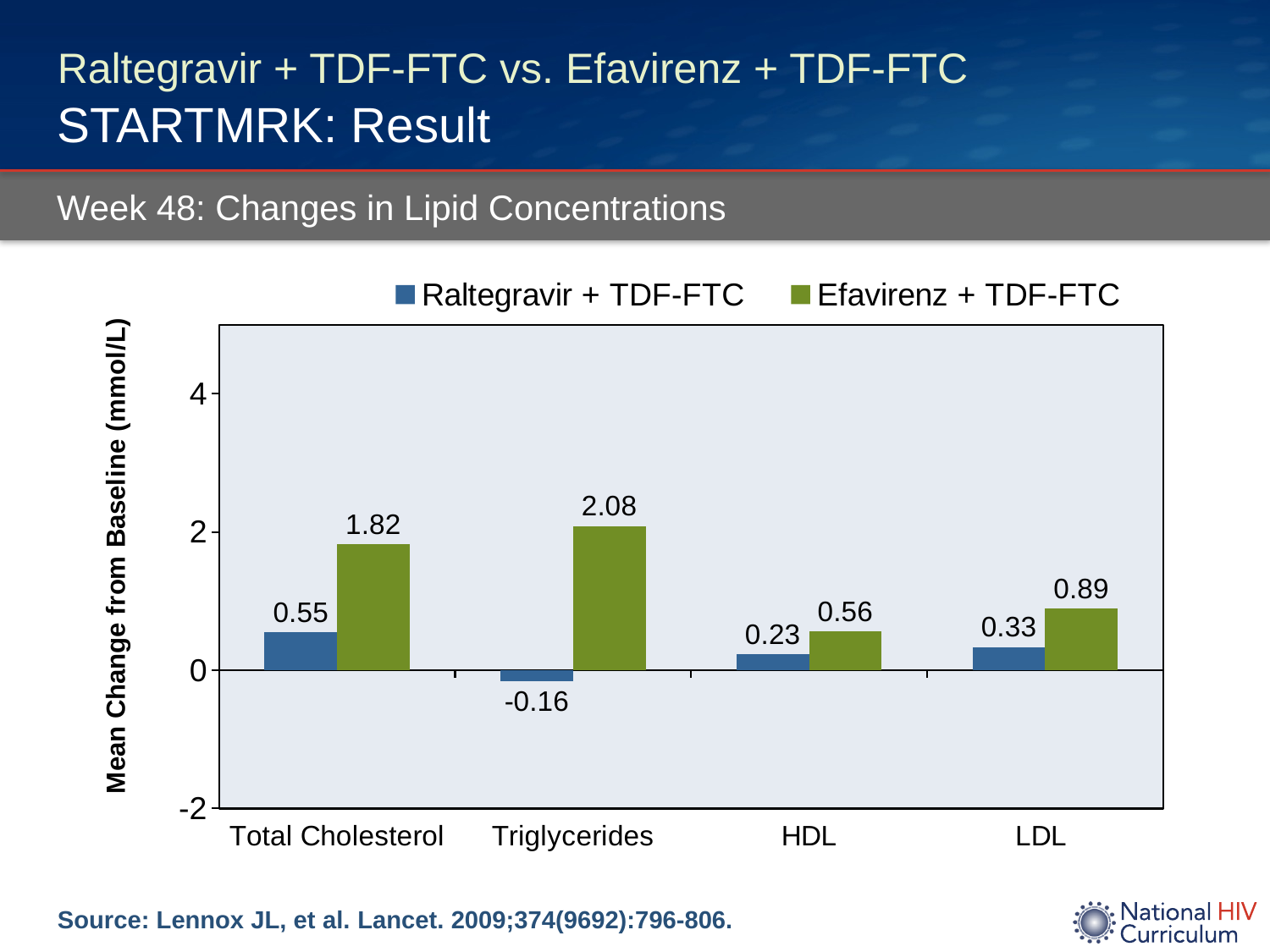
Which lipid category has the lowest value for Raltegravir + TDF-FTC? Triglycerides What is the difference between the Efavirenz + TDF-FTC and Raltegravir + TDF-FTC values for Total Cholesterol? 1.27 For LDL, which group has the larger mean change from baseline? Efavirenz + TDF-FTC What is the mean change from baseline in Triglycerides for Raltegravir + TDF-FTC? -0.16 What is the mean change from baseline in Triglycerides for Efavirenz + TDF-FTC? 2.08 What is the difference between the Efavirenz + TDF-FTC and Raltegravir + TDF-FTC values for HDL? 0.33 What is the mean change from baseline in Total Cholesterol for Raltegravir + TDF-FTC? 0.55 Which lipid category has the highest value for Efavirenz + TDF-FTC? Triglycerides How many lipid categories are shown on the x axis? 4 What is the mean change from baseline in LDL for Efavirenz + TDF-FTC? 0.89 How many series does the legend list? 2 What kind of chart is shown on the slide? Bar chart